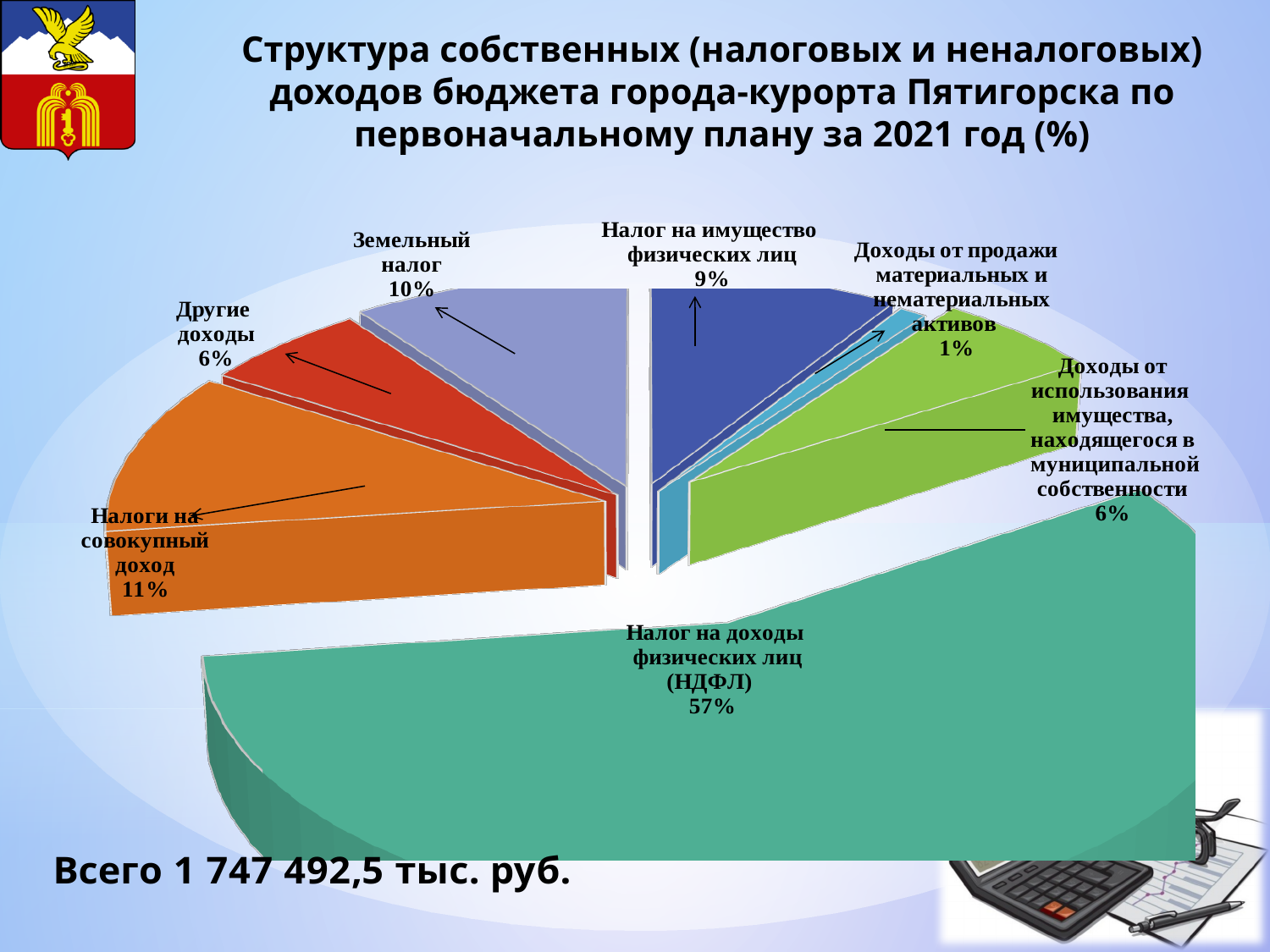
Сколько категорий (секторов) показано на диаграмме? 7 Какую долю составляет земельный налог? 10% Какую долю составляют доходы от продажи материальных и нематериальных активов? 1% Какую долю составляет налог на доходы физических лиц (НДФЛ)? 57% Какую долю составляет налог на имущество физических лиц? 9% Какая категория имеет наименьшую долю в структуре доходов? Доходы от продажи материальных и нематериальных активов Какой тип диаграммы показан на слайде? Круговая диаграмма Какую долю составляют налоги на совокупный доход? 11% Какая общая сумма собственных доходов указана на слайде? 1 747 492,5 тыс. руб. На сколько процентных пунктов доля НДФЛ больше доли налогов на совокупный доход? 46 Что больше: доля земельного налога или доля налога на имущество физических лиц? Земельный налог Какая категория имеет наибольшую долю в структуре доходов? Налог на доходы физических лиц (НДФЛ)